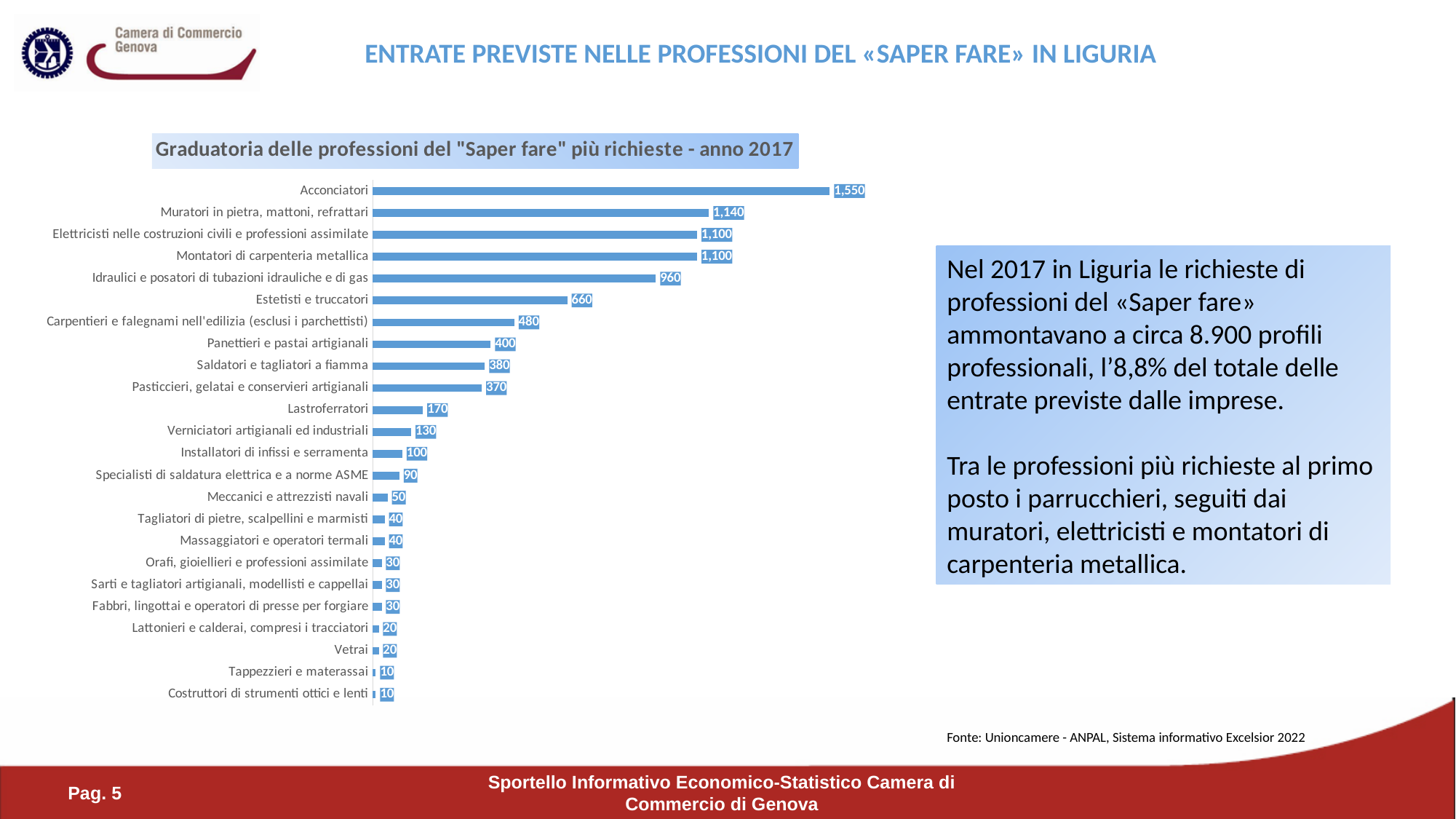
What is the value for Lastroferratori? 170 What is the value for Idraulici e posatori di tubazioni idrauliche e di gas? 960 What is the title of the chart? Graduatoria delle professioni del "Saper fare" più richieste - anno 2017 What is the difference between the values for Estetisti e truccatori and Carpentieri e falegnami nell'edilizia (esclusi i parchettisti)? 180 What is the value for Vetrai? 20 Which is larger, the value for Verniciatori artigianali ed industriali or the value for Installatori di infissi e serramenta? Verniciatori artigianali ed industriali What is the value for Acconciatori? 1,550 Which profession has the highest value? Acconciatori What is the difference between the values for Acconciatori and Muratori in pietra, mattoni, refrattari? 410 How many professions are listed in the chart? 24 What kind of chart is shown on the slide? Bar chart Which is larger, the value for Saldatori e tagliatori a fiamma or the value for Panettieri e pastai artigianali? Panettieri e pastai artigianali